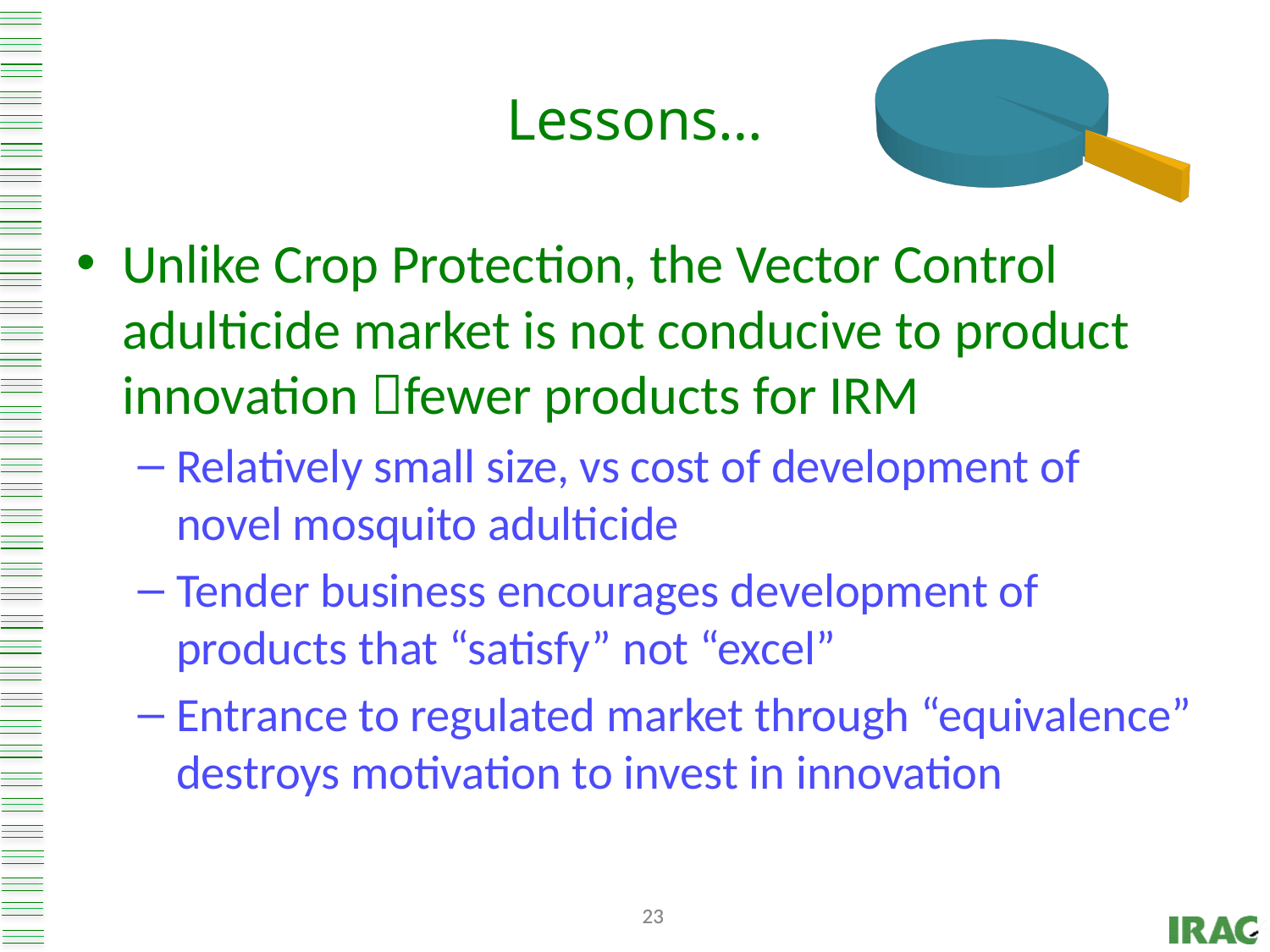
Which slice of the pie chart is larger, the teal one or the gold one? the teal one How many slices does the pie chart have? 2 Does the pie chart display a legend? No Which colour slice is the smallest in the pie chart? gold Which slice of the pie chart is pulled out (exploded) from the rest of the pie? the gold slice Which colour slice is the largest in the pie chart? teal What kind of chart is shown in the top right of the slide? pie chart